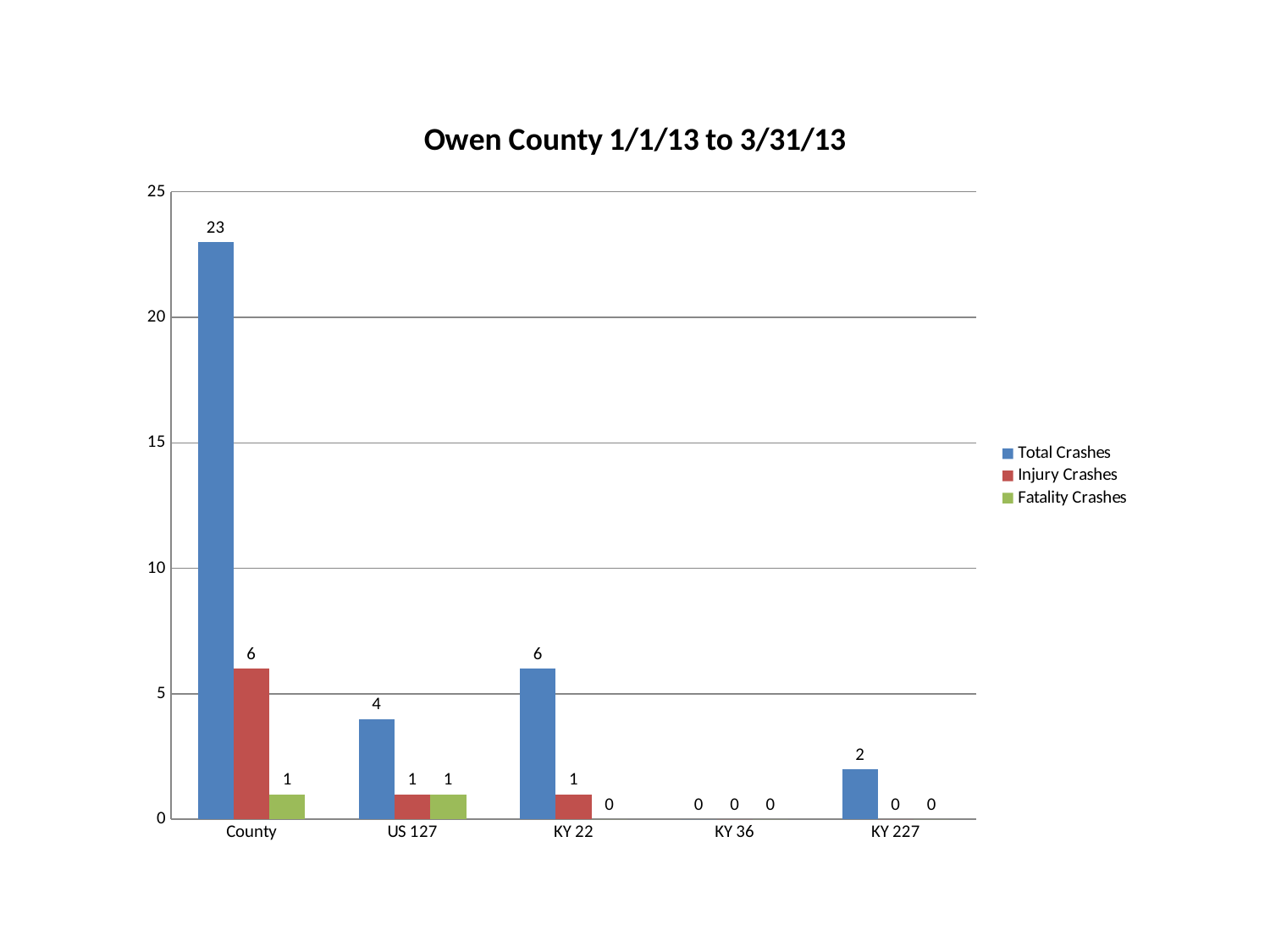
Which category has the highest Total Crashes value? County What is the value of Total Crashes for County? 23 Is the value of Total Crashes for County greater or less than 20? greater How many series does the legend list? 3 Which is larger: Total Crashes for US 127 or Total Crashes for KY 22? KY 22 What is the difference between Total Crashes for County and Total Crashes for KY 22? 17 Which category has the lowest Total Crashes value? KY 36 What type of chart is shown on the slide? bar chart What is the value of Fatality Crashes for KY 22? 0 What is the value of Injury Crashes for US 127? 1 What is the value of Total Crashes for KY 227? 2 How many categories are shown on the x axis? 5